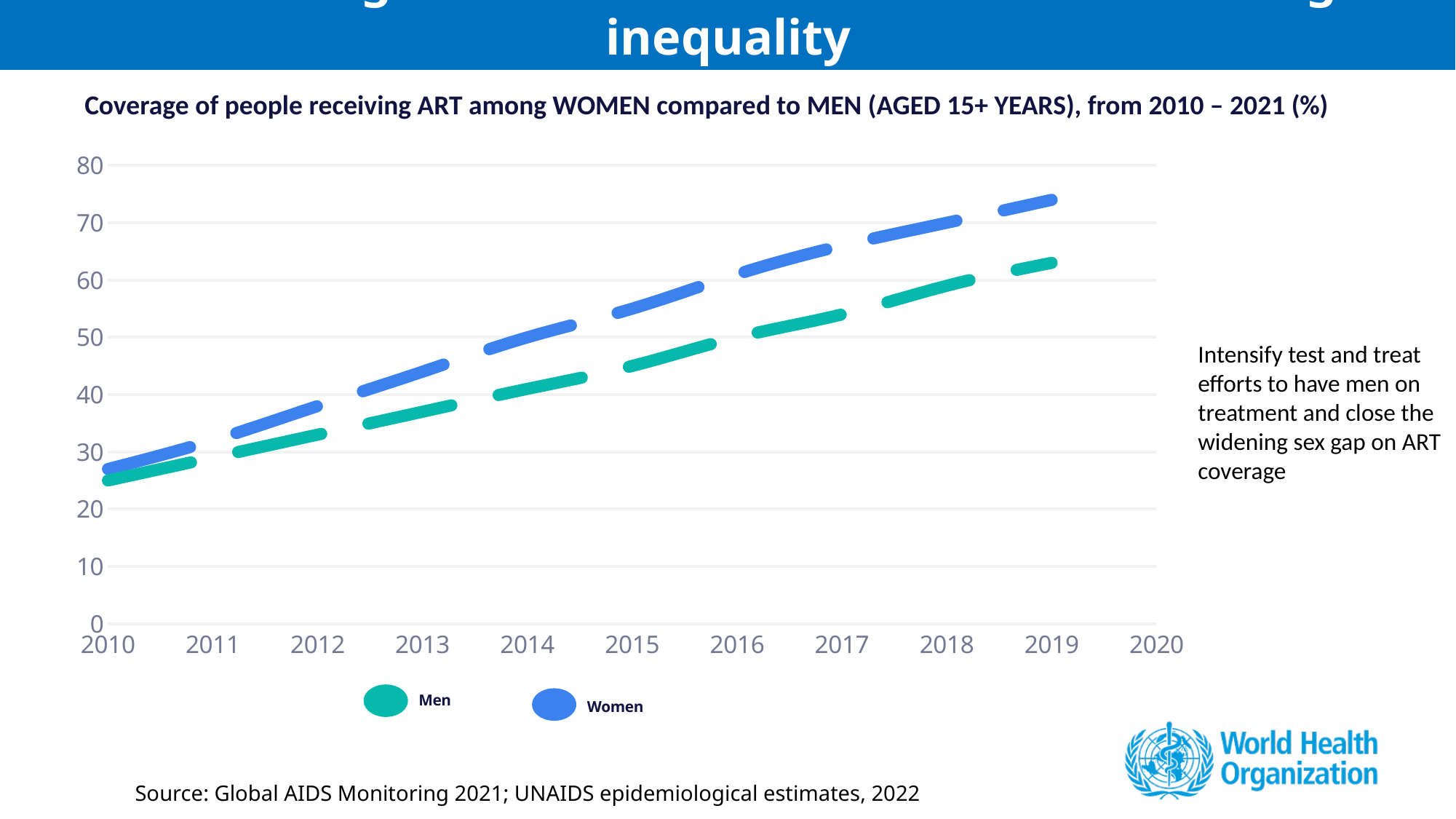
Is the value for Women in 2015 greater or less than 50? greater Which two series are shown in the legend? Men and Women What kind of chart is shown on the slide? Line chart Is the value for Women in 2019 greater or less than 70? greater What colour is the line for Women? Blue Do the ART coverage values for Men rise or fall from 2010 to 2019? Rise How many series does the legend list? 2 In 2019, which series has the higher ART coverage, Men or Women? Women Is the value for Men in 2019 greater or less than 60? greater In which year is the ART coverage for Women at its highest? 2019 Do the ART coverage values for Women rise or fall from 2010 to 2019? Rise